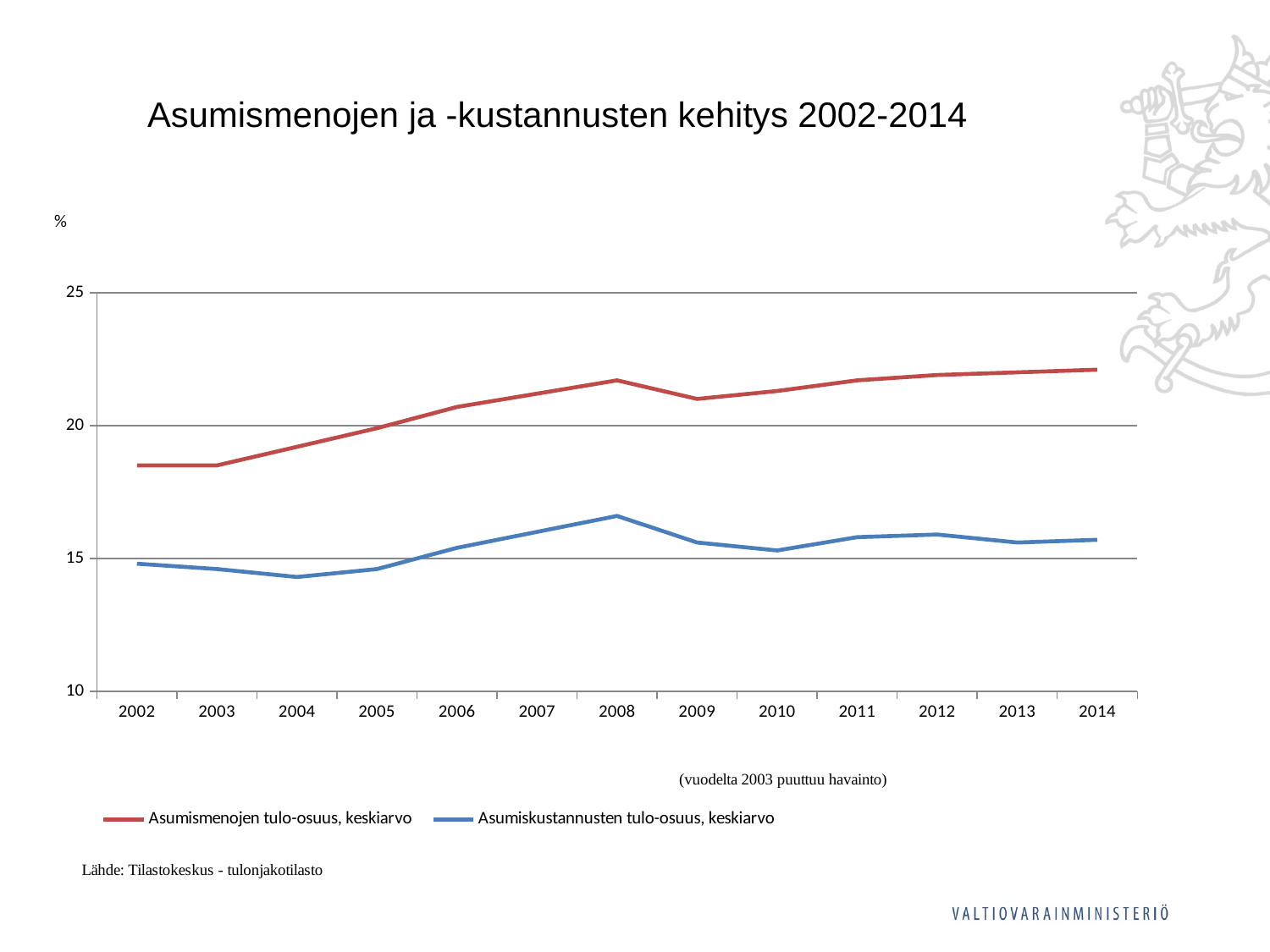
Which colour is used for the Asumiskustannusten tulo-osuus, keskiarvo line? blue Does Asumismenojen tulo-osuus, keskiarvo generally rise or fall from 2002 to 2014? rise Is the value for Asumiskustannusten tulo-osuus, keskiarvo in 2004 greater or less than 15? less In which year does Asumiskustannusten tulo-osuus, keskiarvo reach its lowest value? 2004 Is the value for Asumismenojen tulo-osuus, keskiarvo in 2014 greater or less than 20? greater What kind of chart is shown on the slide? line chart How many years are shown on the x axis? 13 Is the value for Asumiskustannusten tulo-osuus, keskiarvo in 2008 greater or less than 15? greater In which year does Asumiskustannusten tulo-osuus, keskiarvo reach its highest value? 2008 In 2010, which series has the larger value, Asumismenojen tulo-osuus or Asumiskustannusten tulo-osuus? Asumismenojen tulo-osuus, keskiarvo How many series does the legend list? 2